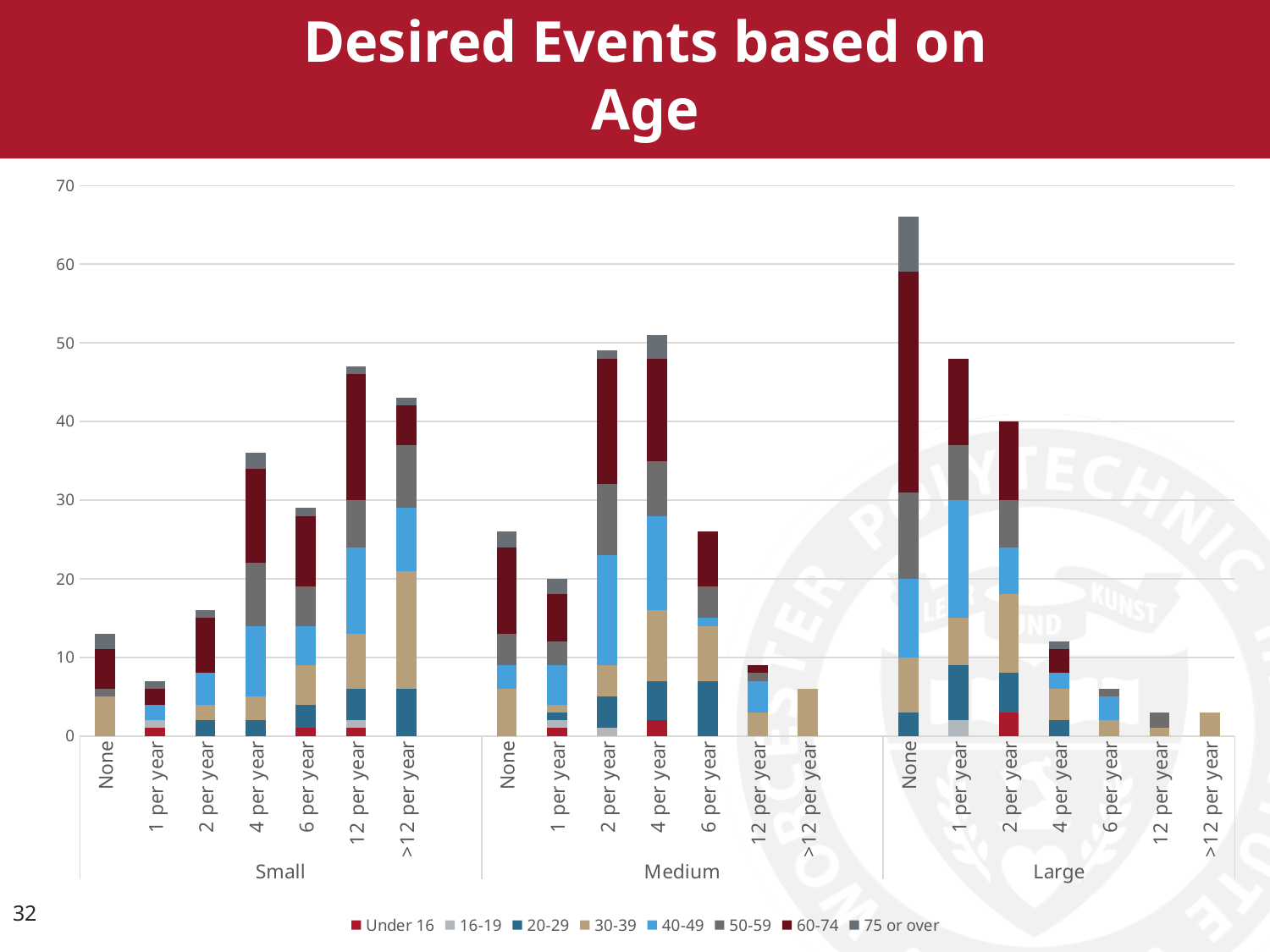
How many size groups (Small, Medium, Large) are shown along the x axis? 3 Within the Small group, which category has the lowest bar? 1 per year Is the total for 12 per year in the Small group greater or less than 40? greater How many bars are plotted in the chart in total? 21 Is the total for 1 per year in the Small group greater or less than 10? less Which is larger: the total for 1 per year or 2 per year in the Large group? 1 per year Which is larger: the total for 4 per year or 6 per year in the Small group? 4 per year Is the total for None in the Large group greater or less than 60? greater Which bar is the tallest in the chart? Large, None How many series does the legend list? 8 What kind of chart is shown on the slide? bar chart What is the title of the chart? Desired Events based on Age